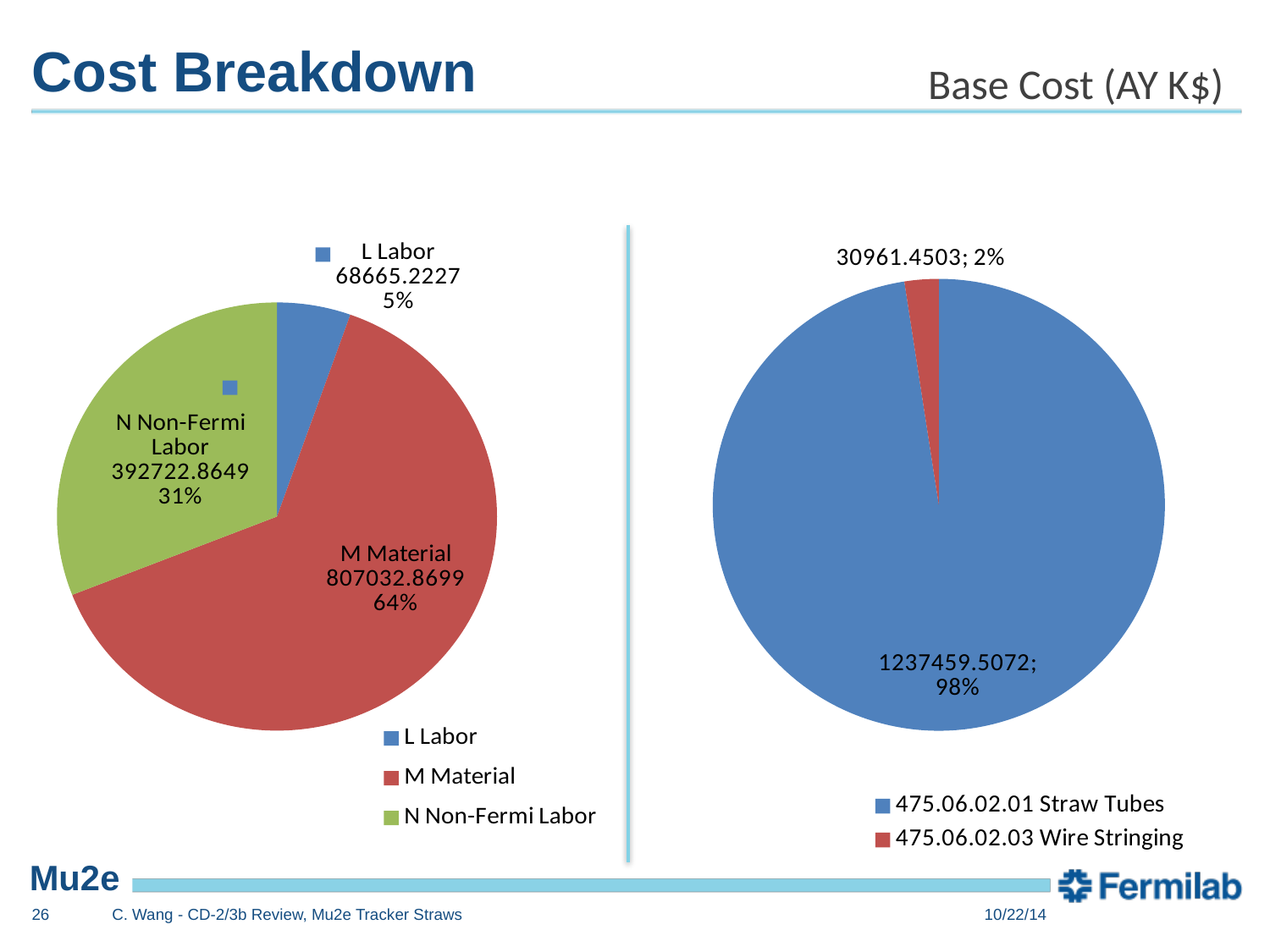
On the right pie chart, what is the value for 475.06.02.01 Straw Tubes? 1237459.5072 On the left pie chart, how many categories are shown? 3 What kind of chart is the chart on the left? Pie chart On the right pie chart, what share of the pie does 475.06.02.03 Wire Stringing represent? 2% On the left pie chart, what colour is the M Material slice? Red On the left pie chart, which category has the largest slice? M Material How many entries does the legend of the right pie chart list? 2 On the left pie chart, what is the value for M Material? 807032.8699 On the left pie chart, what share of the pie does N Non-Fermi Labor represent? 31% On the left pie chart, what is the value for L Labor? 68665.2227 On the left pie chart, which category has the smallest slice? L Labor On the right pie chart, which category is larger, Straw Tubes or Wire Stringing? 475.06.02.01 Straw Tubes